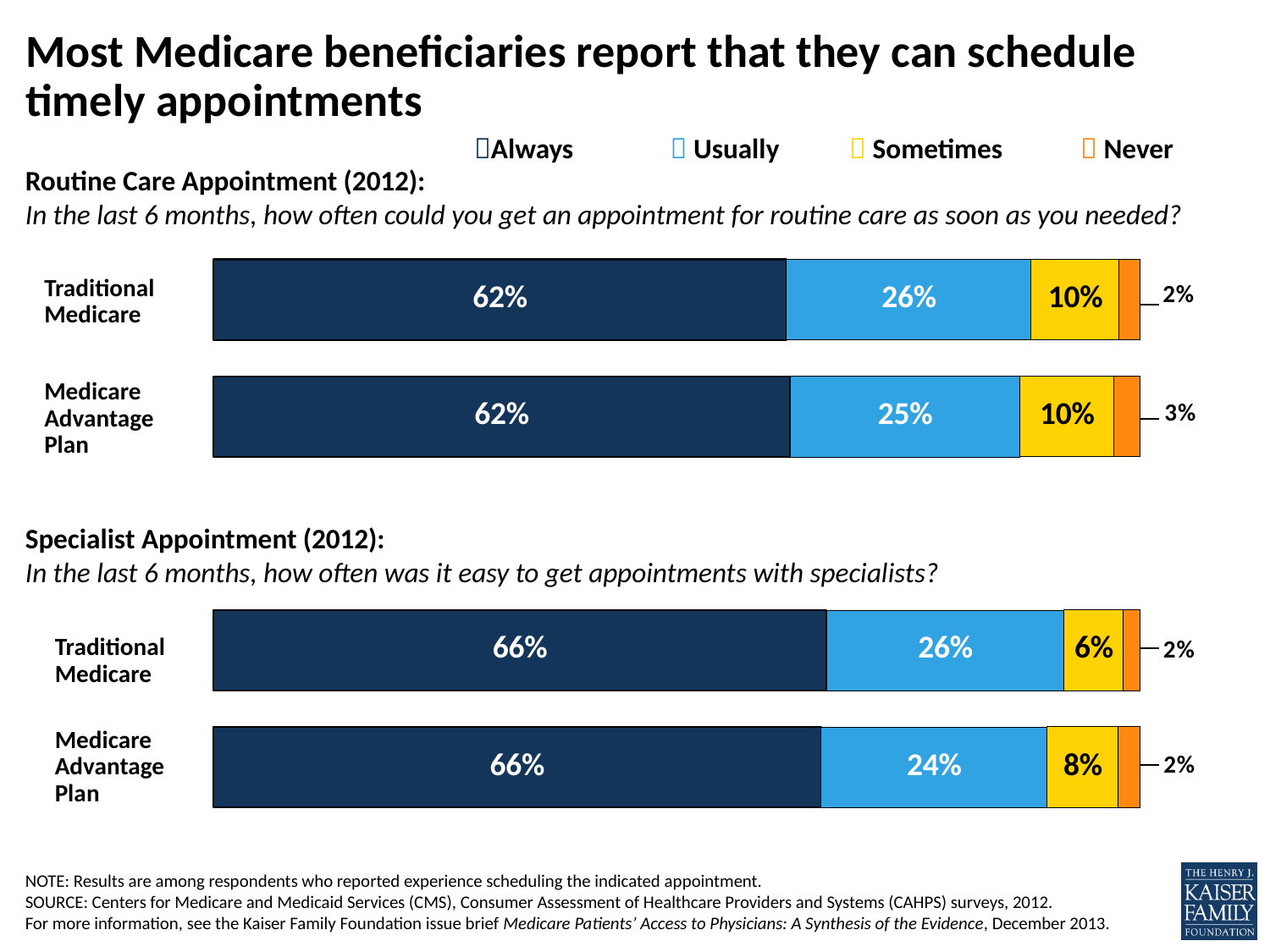
In the Routine Care Appointment (2012) chart, what percentage of Medicare Advantage Plan beneficiaries answered "Usually"? 25% In the Specialist Appointment (2012) chart, what percentage of Medicare Advantage Plan beneficiaries answered "Usually"? 24% How many categories (plan types) are shown in the Routine Care Appointment (2012) chart? 2 In the Routine Care Appointment (2012) chart, which response category has the largest share for Traditional Medicare? Always In the Routine Care Appointment (2012) chart, what percentage of Traditional Medicare beneficiaries answered "Always"? 62% In the Specialist Appointment (2012) chart, what percentage of Traditional Medicare beneficiaries answered "Sometimes"? 6% In the Specialist Appointment (2012) chart, which is larger: the "Usually" value for Traditional Medicare or for Medicare Advantage Plan? Traditional Medicare In the Specialist Appointment (2012) chart, what is the difference between the "Sometimes" values for Medicare Advantage Plan and Traditional Medicare? 2% How many series does the legend list? 4 What kind of chart is the Specialist Appointment (2012) chart? Stacked bar chart In the Routine Care Appointment (2012) chart, what percentage of Medicare Advantage Plan beneficiaries answered "Never"? 3% In the Specialist Appointment (2012) chart, which response category has the smallest share for Medicare Advantage Plan? Never